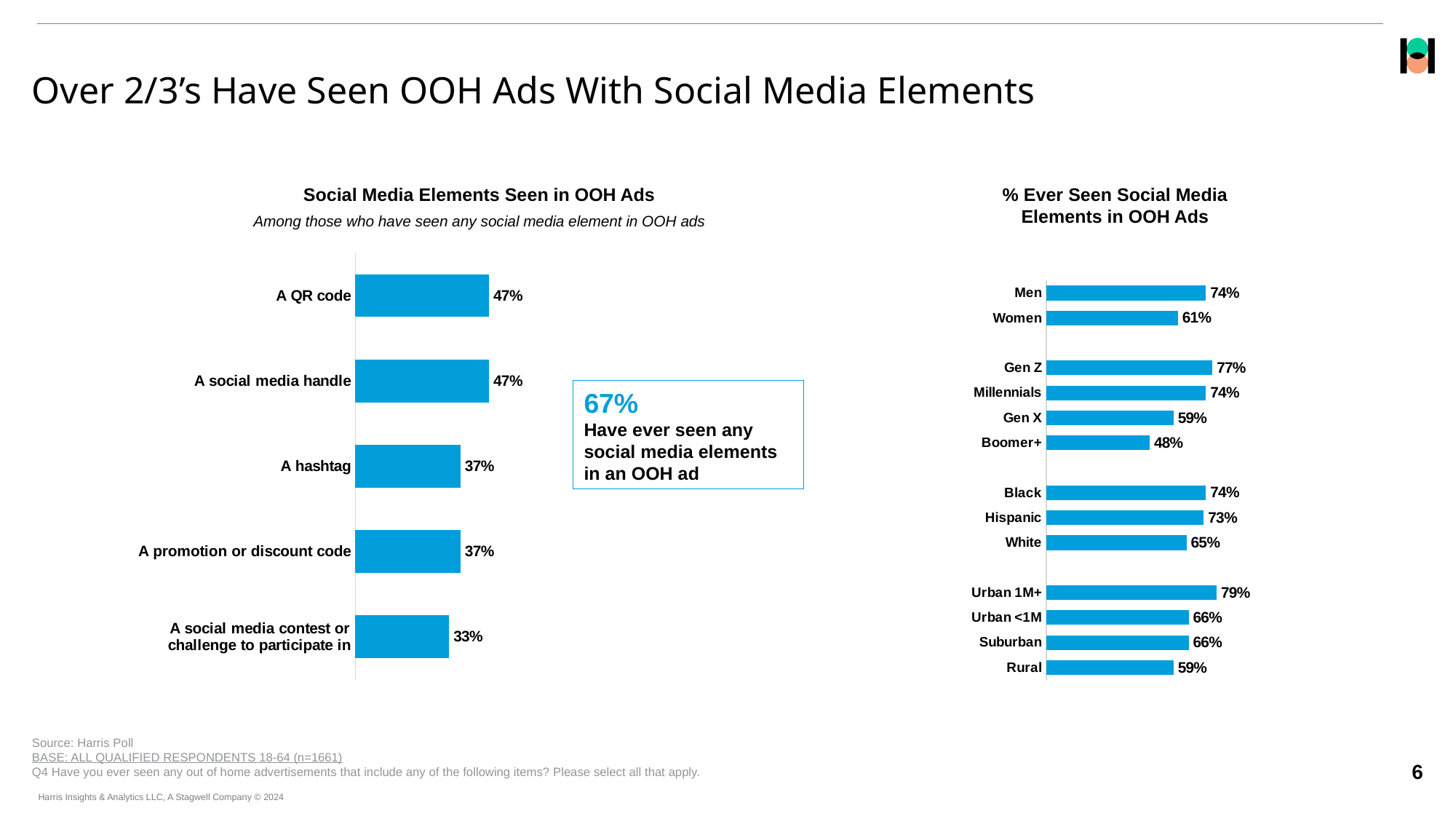
In the '% Ever Seen Social Media Elements in OOH Ads' chart, what is the value for Boomer+? 48% In the 'Social Media Elements Seen in OOH Ads' chart, which category has the lowest value? A social media contest or challenge to participate in In the 'Social Media Elements Seen in OOH Ads' chart, what is the value for 'A hashtag'? 37% In the '% Ever Seen Social Media Elements in OOH Ads' chart, which category has the lowest value? Boomer+ What kind of chart is the 'Social Media Elements Seen in OOH Ads' chart? Bar chart In the '% Ever Seen Social Media Elements in OOH Ads' chart, which category has the highest value? Urban 1M+ How many categories are shown in the 'Social Media Elements Seen in OOH Ads' chart? 5 In the '% Ever Seen Social Media Elements in OOH Ads' chart, which is larger, Gen Z or Gen X? Gen Z What percentage is shown in the callout box between the two charts as having ever seen any social media elements in an OOH ad? 67% In the '% Ever Seen Social Media Elements in OOH Ads' chart, what is the difference between Men and Women? 13% In the 'Social Media Elements Seen in OOH Ads' chart, what is the difference between 'A QR code' and 'A social media contest or challenge to participate in'? 14% How many categories are shown in the '% Ever Seen Social Media Elements in OOH Ads' chart? 13